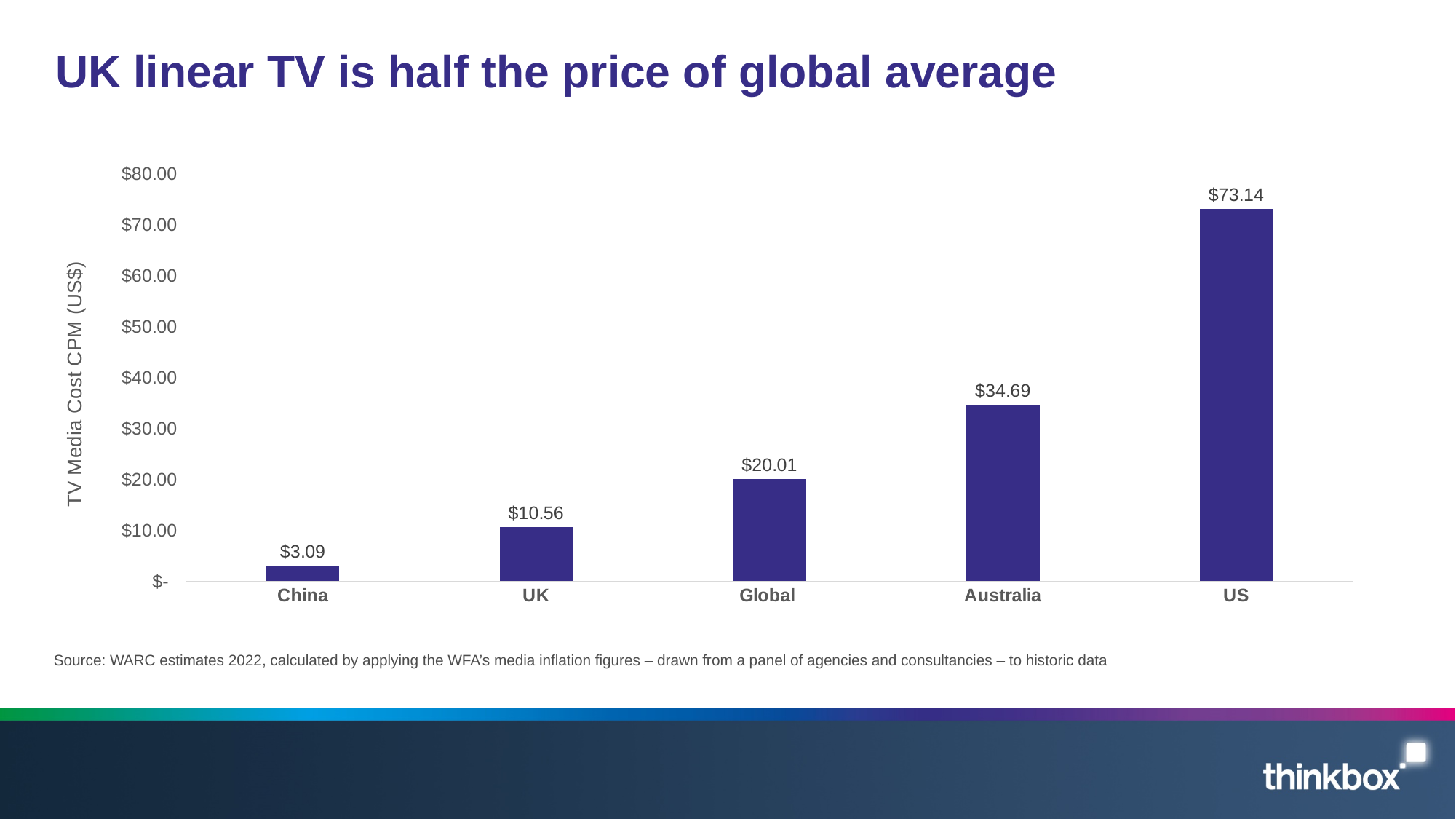
Which country or region has the lowest TV media cost CPM? China What kind of chart is shown on the slide? Bar chart What is the TV media cost CPM for Australia? $34.69 What is the label on the vertical axis of the chart? TV Media Cost CPM (US$) What is the Global TV media cost CPM? $20.01 What is the difference between the US and UK TV media cost CPM? $62.58 Which has a higher TV media cost CPM, Australia or Global? Australia How many countries or regions are shown on the chart? 5 Is the value for Australia greater or less than $30.00? greater What is the TV media cost CPM for the UK? $10.56 Which country or region has the highest TV media cost CPM? US What is the TV media cost CPM for the US? $73.14